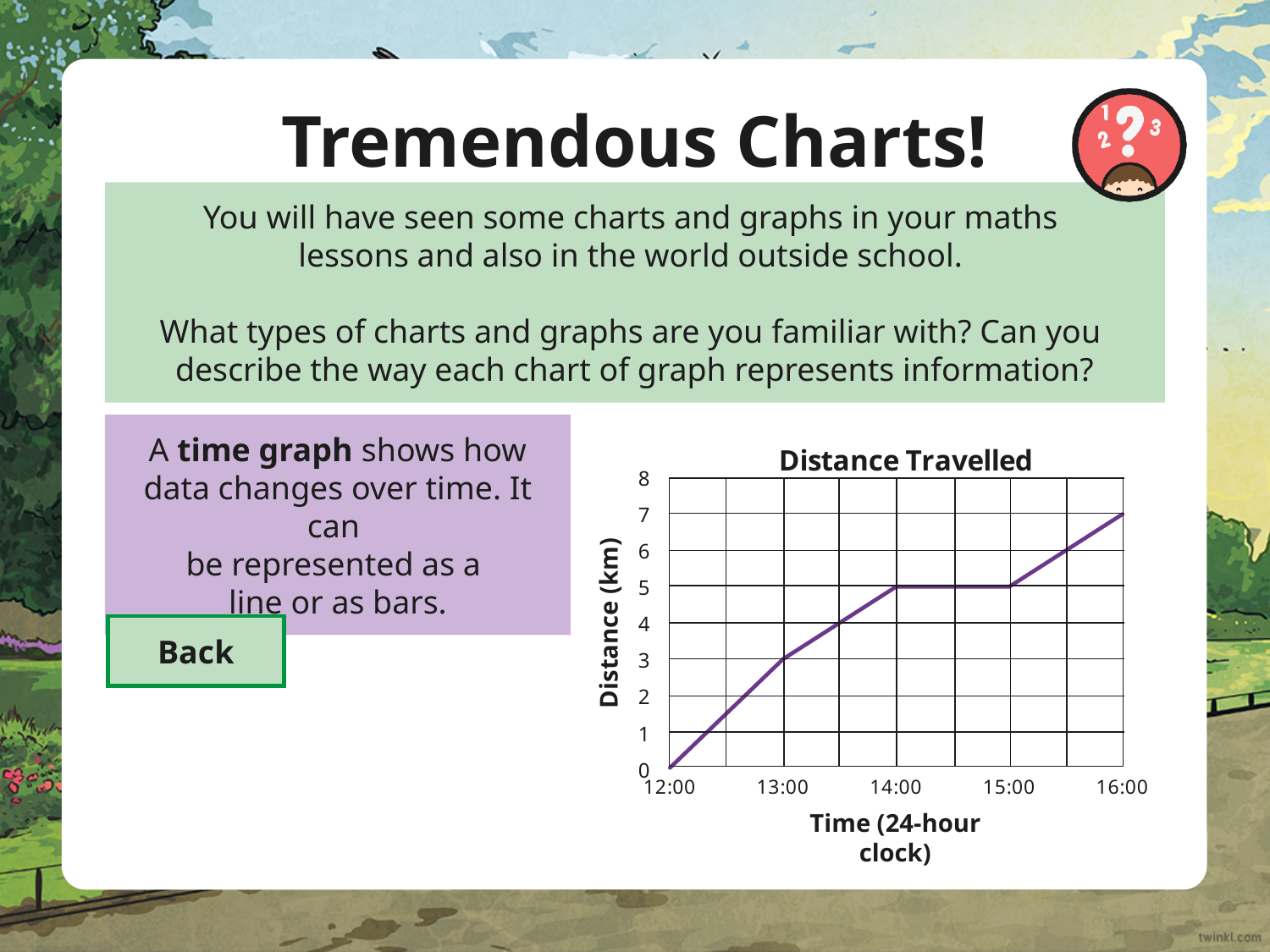
What is the label on the y axis of the chart? Distance (km) What type of chart is shown on the slide? line chart What is the title of the chart? Distance Travelled Do the values rise or fall along the x axis from 12:00 to 16:00? rise Is the distance travelled at 12:30 greater or less than 3? less What is the distance travelled at 16:00? 7 km At which time is the distance travelled highest? 16:00 What is the distance travelled at 14:00? 5 km What is the distance travelled at 13:00? 3 km What is the distance travelled at 12:00? 0 km Which is larger, the distance travelled at 15:00 or at 13:00? 15:00 What is the difference in distance travelled between 16:00 and 14:00? 2 km